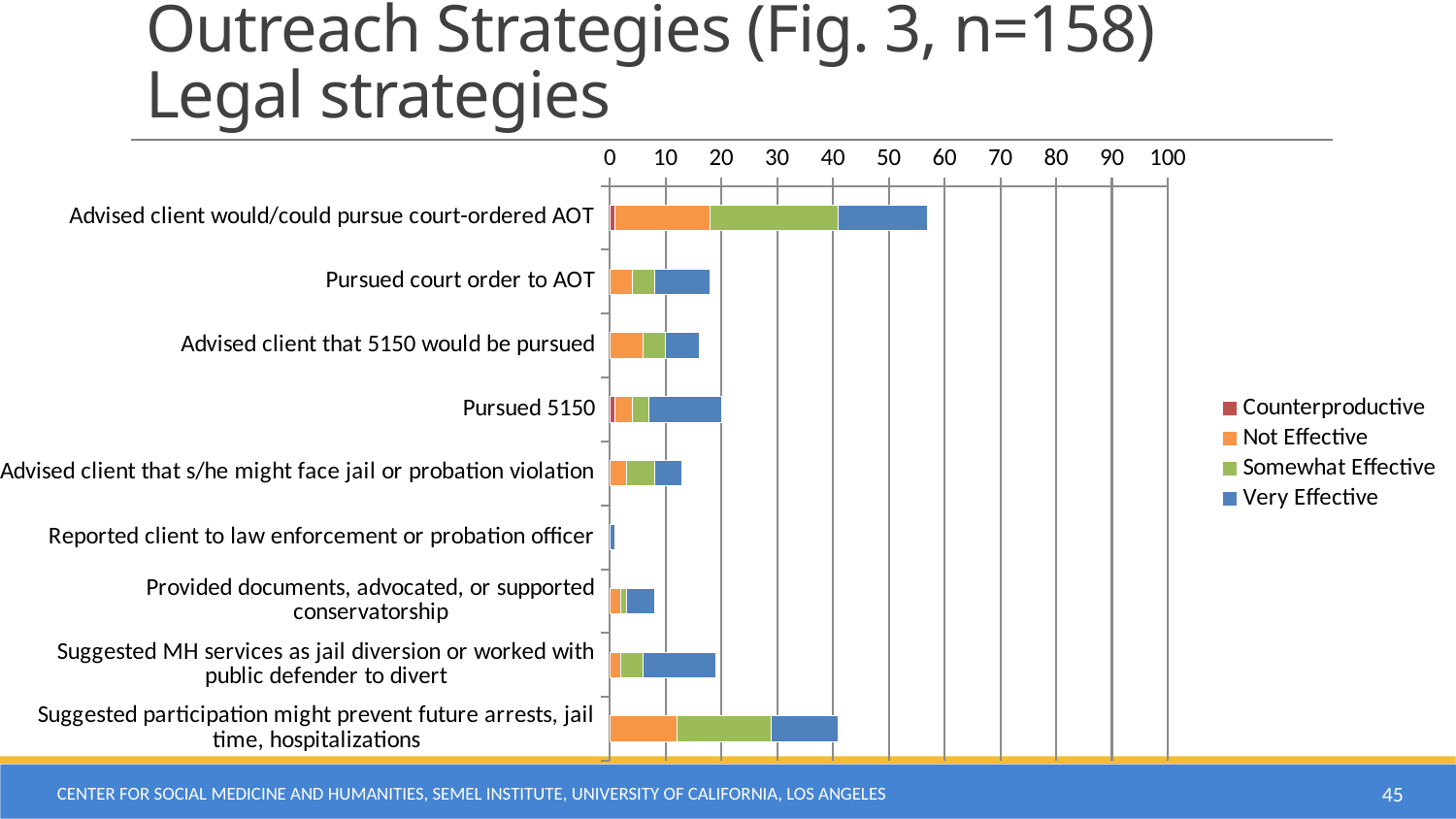
Which has the longer total bar: 'Pursued 5150' or 'Provided documents, advocated, or supported conservatorship'? Pursued 5150 How many series does the legend list? 4 Which legal strategy has the shortest total bar? Reported client to law enforcement or probation officer Is the total bar for 'Provided documents, advocated, or supported conservatorship' greater or less than 10? less Is the total bar for 'Suggested participation might prevent future arrests, jail time, hospitalizations' greater or less than 30? greater Which legal strategy has the longest total bar? Advised client would/could pursue court-ordered AOT Is the total bar for 'Pursued court order to AOT' greater or less than 20? less How many legal strategy categories are plotted on the chart? 9 What are the four series listed in the legend? Counterproductive, Not Effective, Somewhat Effective, Very Effective What kind of chart is shown on the slide? Stacked bar chart Which series in the legend is shown in blue? Very Effective